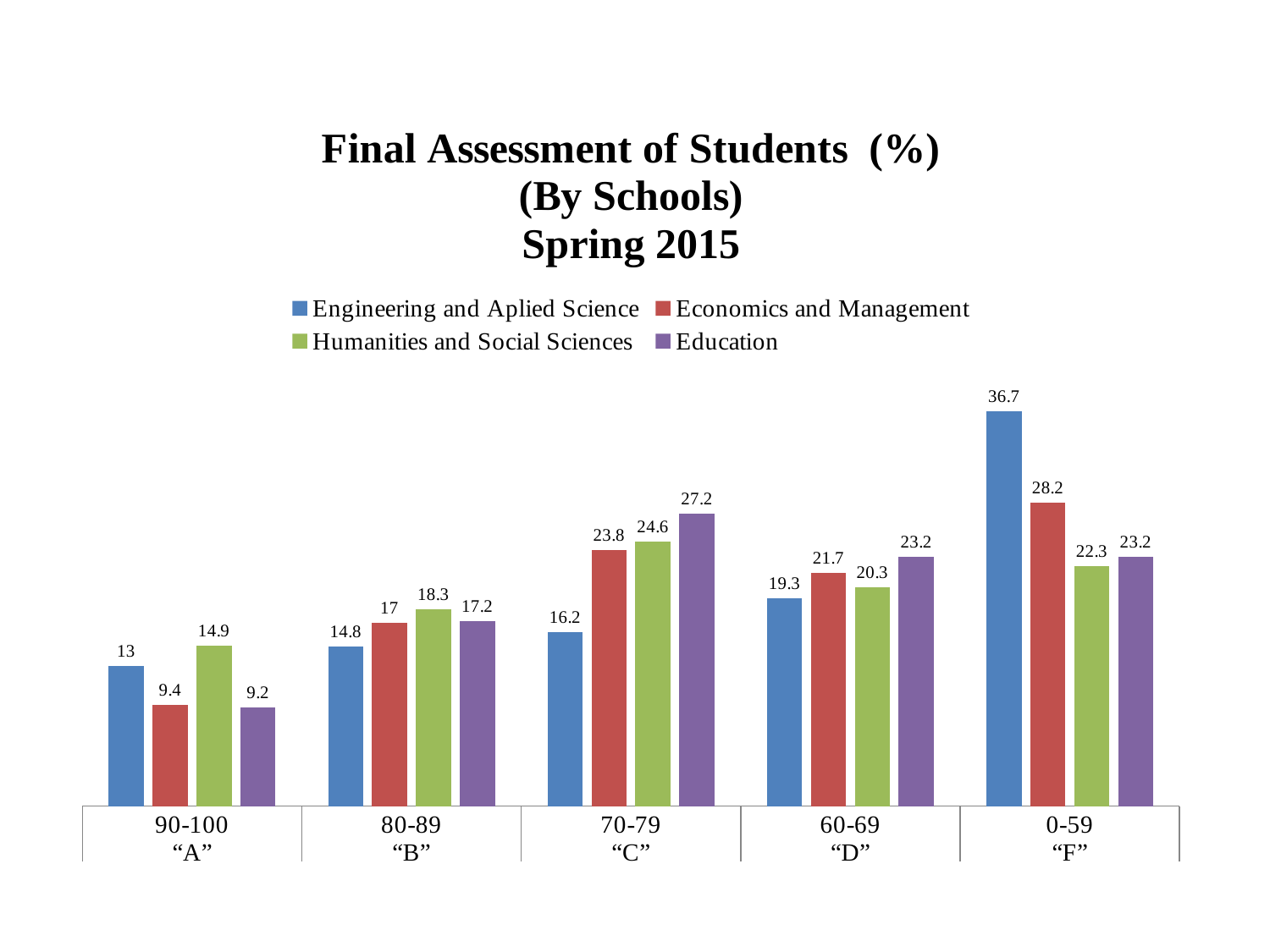
Which category has the highest value for Economics and Management? 0-59 "F" What is the title of the chart? Final Assessment of Students (%) (By Schools) Spring 2015 In the 60-69 "D" category, which is larger: Economics and Management or Humanities and Social Sciences? Economics and Management What is the difference between the Education value and the Engineering and Aplied Science value in the 70-79 "C" category? 11 What is the value for Engineering and Aplied Science in the 0-59 "F" category? 36.7 How many series does the legend list? 4 What is the value for Humanities and Social Sciences in the 80-89 "B" category? 18.3 How many grade categories are shown on the x axis? 5 Which category has the lowest value for Engineering and Aplied Science? 90-100 "A" What kind of chart is shown on the slide? Bar chart Do the Engineering and Aplied Science values rise or fall from the 90-100 "A" category to the 0-59 "F" category? Rise What is the value for Education in the 90-100 "A" category? 9.2